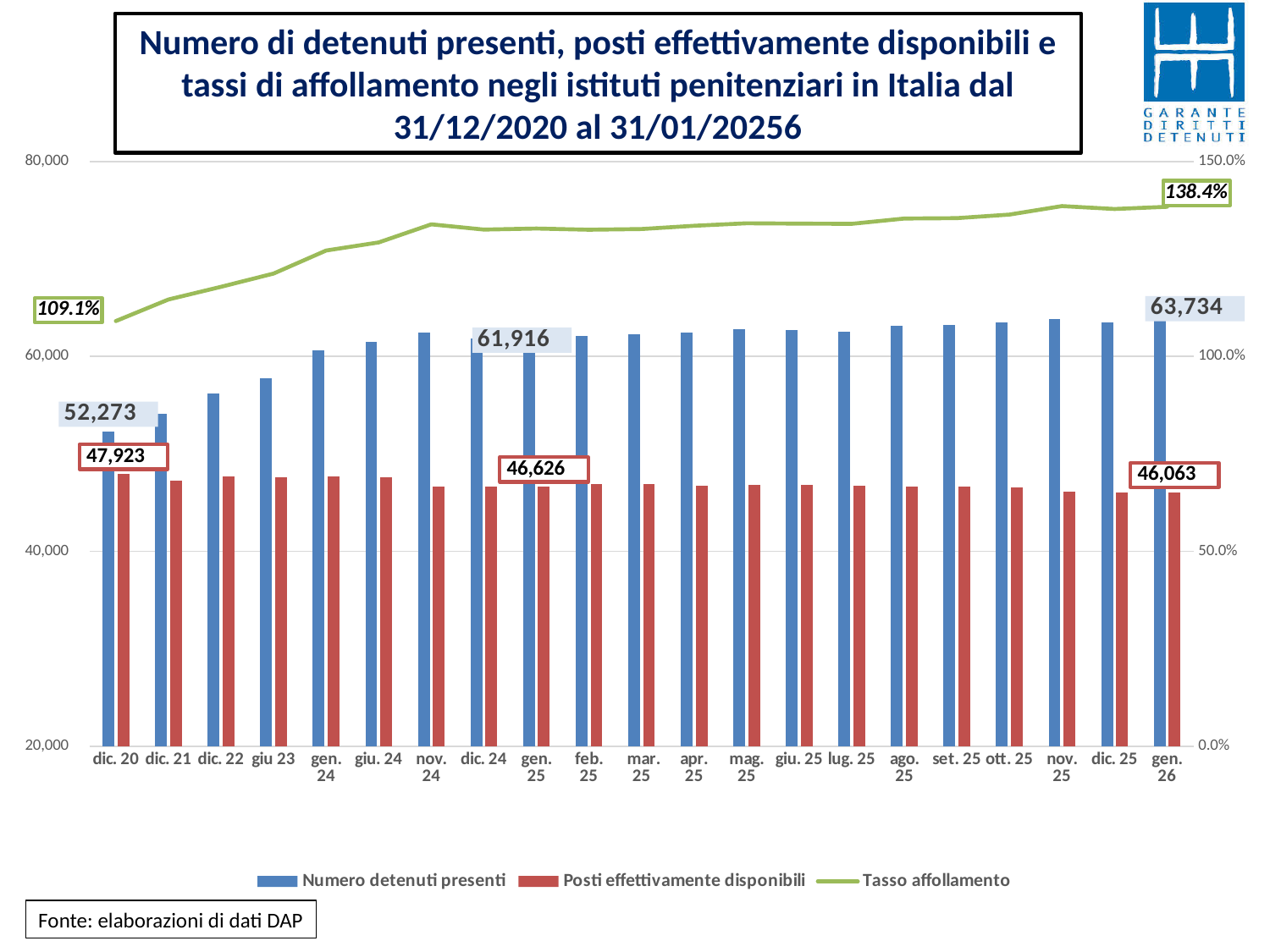
What is the value of 'Numero detenuti presenti' at gen. 26? 63,734 What is the 'Tasso affollamento' at gen. 26? 138.4% By how much did 'Numero detenuti presenti' increase from dic. 20 to gen. 26? 11,461 How many series does the legend list? 3 What is the 'Tasso affollamento' at dic. 20? 109.1% Does the 'Tasso affollamento' line generally rise or fall from dic. 20 to gen. 26? rise What type of chart is shown on the slide? Combined bar and line chart At which time point is 'Numero detenuti presenti' highest? nov. 25 How many time points (categories) are shown on the x axis? 21 What is the value of 'Numero detenuti presenti' at dic. 20? 52,273 What is the value of 'Posti effettivamente disponibili' at dic. 20? 47,923 Is the value of 'Numero detenuti presenti' at dic. 22 greater or less than 60,000? less